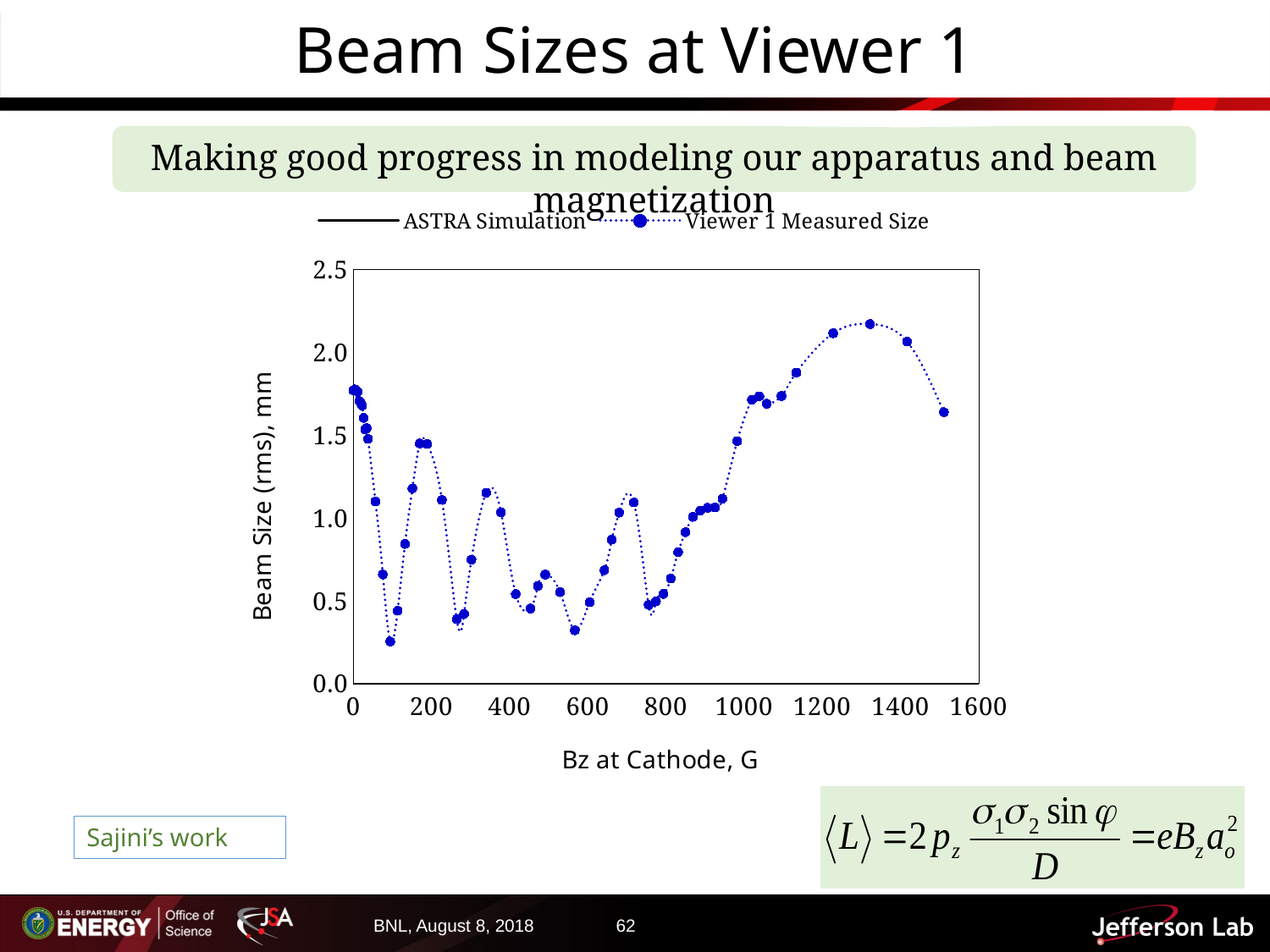
Is the lowest measured beam size found at Bz below 400 G or above 400 G? below 400 G Is the measured beam size at about Bz = 100 G greater or less than 0.5 mm? less Is the peak measured beam size near Bz = 1300 G greater or less than 2.0 mm? greater What are the two series named in the chart legend? ASTRA Simulation and Viewer 1 Measured Size Is the highest measured beam size found at Bz below 800 G or above 800 G? above 800 G What is the title of the x axis of the chart? Bz at Cathode, G How many series does the chart legend list? 2 Is the measured beam size at Bz = 0 G greater or less than 1.5 mm? greater Which is larger: the measured beam size near Bz = 1300 G or the measured beam size at Bz = 0 G? near Bz = 1300 G What kind of chart is shown on the slide? line chart with markers (scatter plot) Between Bz = 1000 G and Bz = 1300 G, does the measured beam size rise or fall? rise